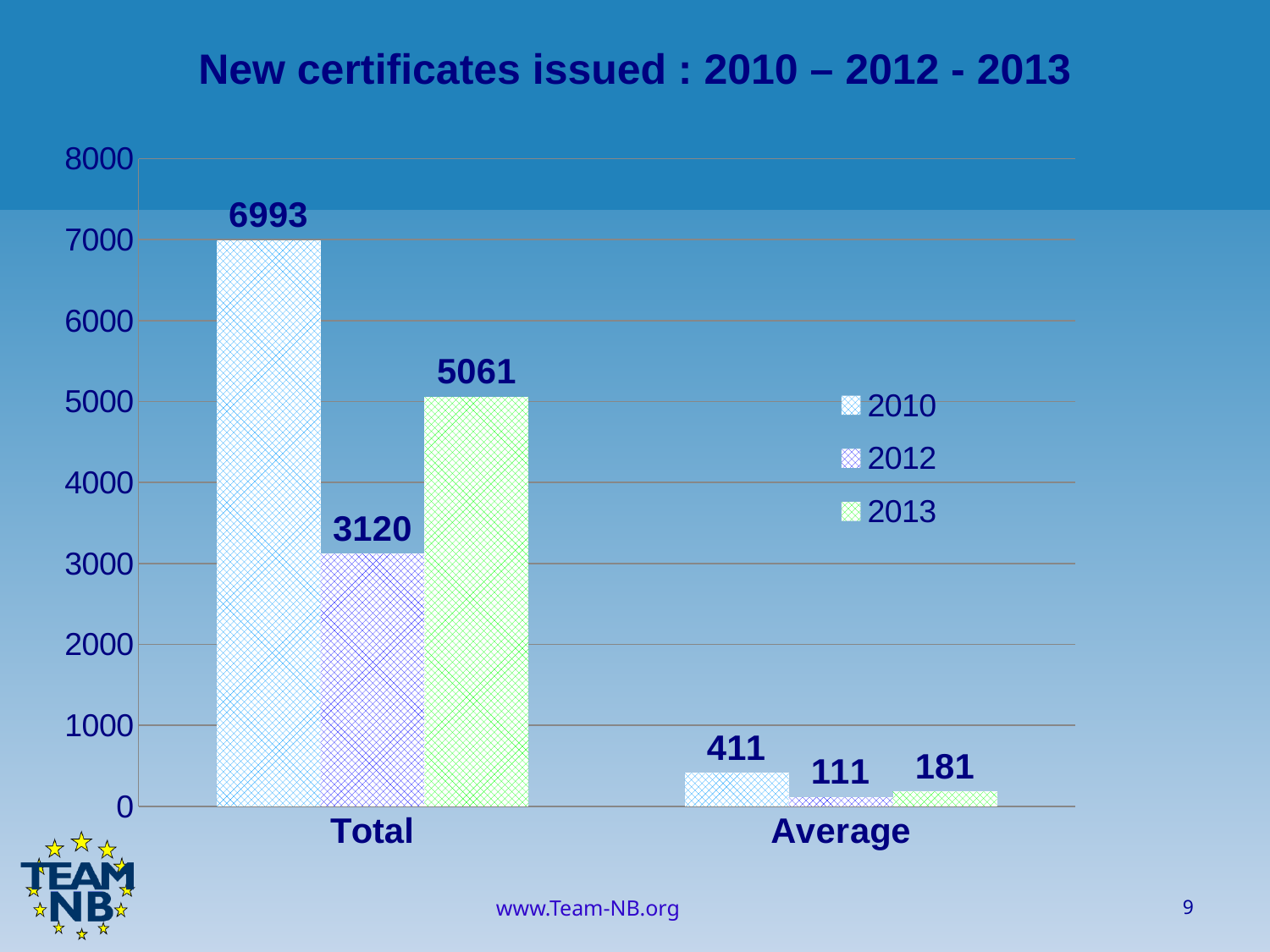
What kind of chart is shown on the slide? Bar chart Which year has the highest Total value? 2010 What is the Total value for 2012? 3120 What is the title of the chart? New certificates issued : 2010 – 2012 - 2013 Which is larger, the Total value for 2013 or the Total value for 2012? 2013 What is the difference between the Total values for 2010 and 2013? 1932 Which year has the lowest Average value? 2012 What is the difference between the Average values for 2013 and 2012? 70 How many series does the legend list? 3 What is the Total value for 2010? 6993 What is the Average value for 2013? 181 What is the Average value for 2012? 111